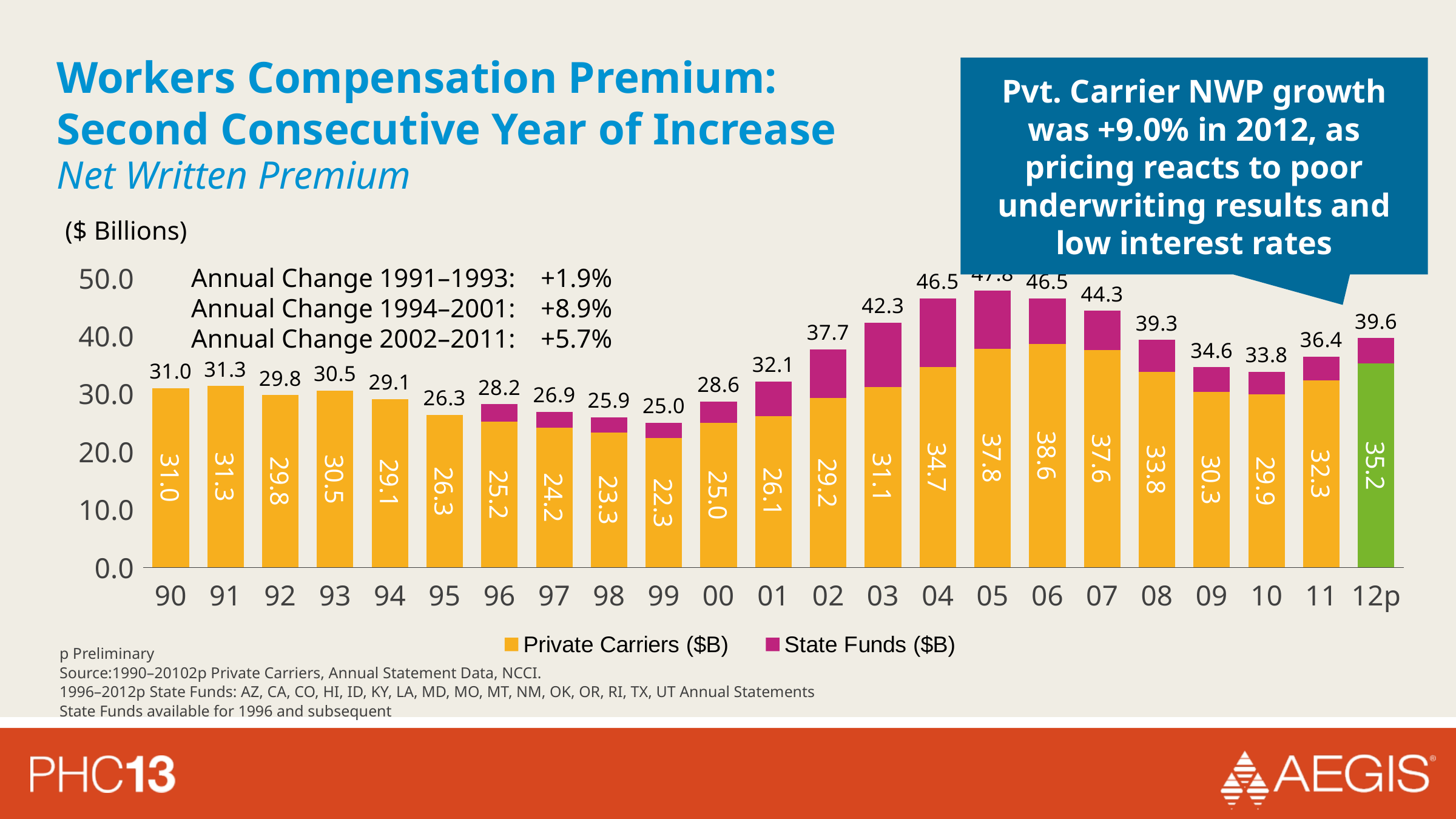
What kind of chart is shown on the slide? stacked bar chart Which year has the lowest Private Carriers value? 99 What is the State Funds value for 12p, computed as the total label minus the Private Carriers label? 4.4 What is the total net written premium shown above the bar for 2003? 42.3 What is the Private Carriers value for 2006? 38.6 How much higher is the total for 2011 than the total for 2010? 2.6 What is the Private Carriers value for 12p? 35.2 How many years (bars) are shown on the x axis? 23 Which is larger, the Private Carriers value for 2004 or for 2008? 2004 Which year has the highest Private Carriers value? 06 Is the total for 2002 greater or less than 40.0? less How many series does the legend list? 2